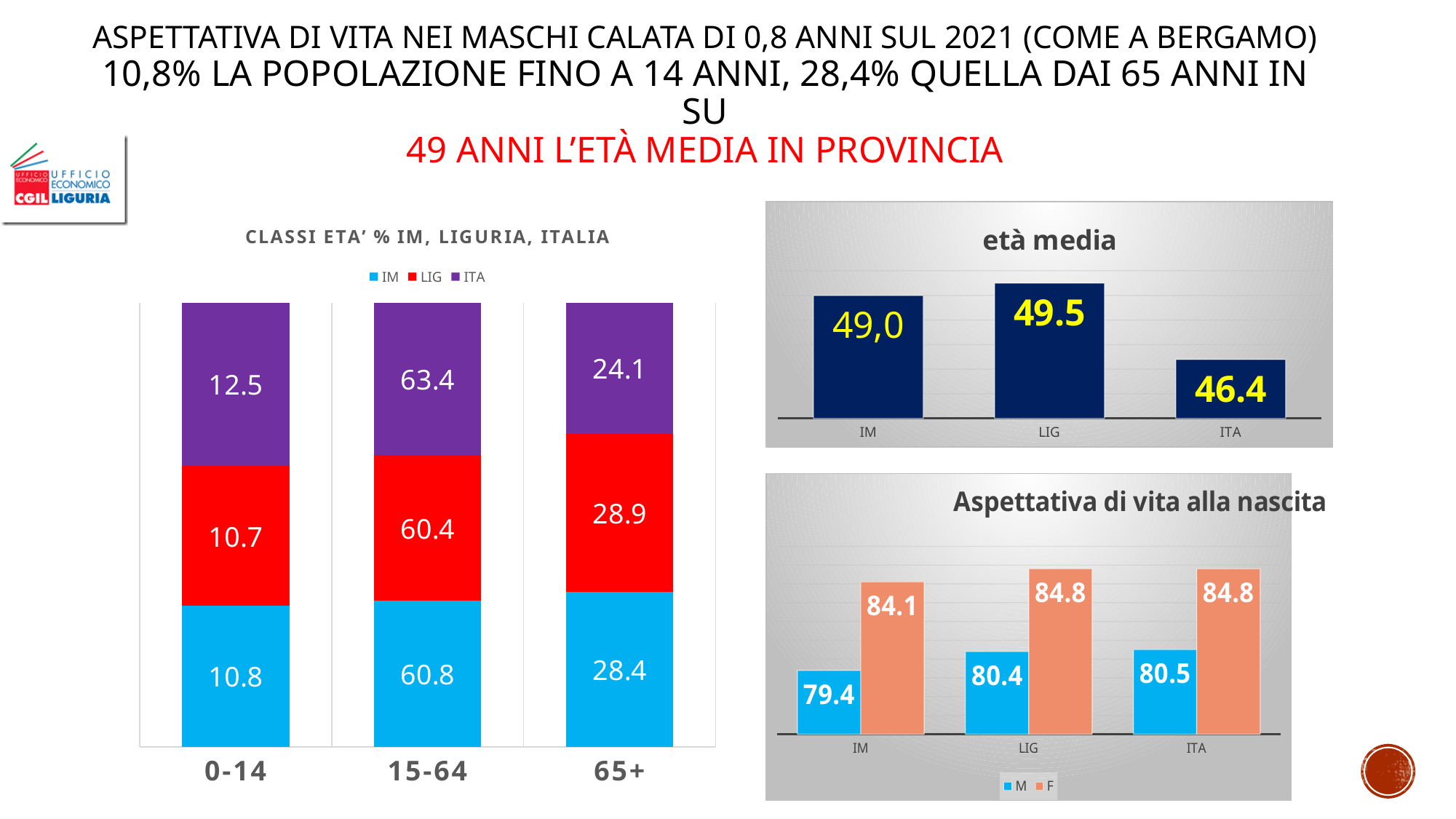
In the 'età media' chart, what is the difference between LIG and ITA? 3.1 In the 'Aspettativa di vita alla nascita' chart, what is the difference between F and M for LIG? 4.4 In the 'CLASSI ETA' % IM, LIGURIA, ITALIA' chart, how many series does the legend list? 3 In the 'CLASSI ETA' % IM, LIGURIA, ITALIA' chart, what is the value for ITA in the 15-64 category? 63.4 In the 'CLASSI ETA' % IM, LIGURIA, ITALIA' chart, what is the difference between the LIG and ITA values in the 0-14 category? 1.8 In the 'età media' chart, which category has the highest value? LIG In the 'CLASSI ETA' % IM, LIGURIA, ITALIA' chart, what is the value for IM in the 65+ category? 28.4 In the 'Aspettativa di vita alla nascita' chart, which is larger, the M value for LIG or the M value for IM? LIG In the 'CLASSI ETA' % IM, LIGURIA, ITALIA' chart, which series has the highest value in the 65+ category? LIG In the 'età media' chart, what is the value for ITA? 46.4 What kind of chart is the 'Aspettativa di vita alla nascita' chart? Bar chart In the 'Aspettativa di vita alla nascita' chart, what is the value for M in IM? 79.4